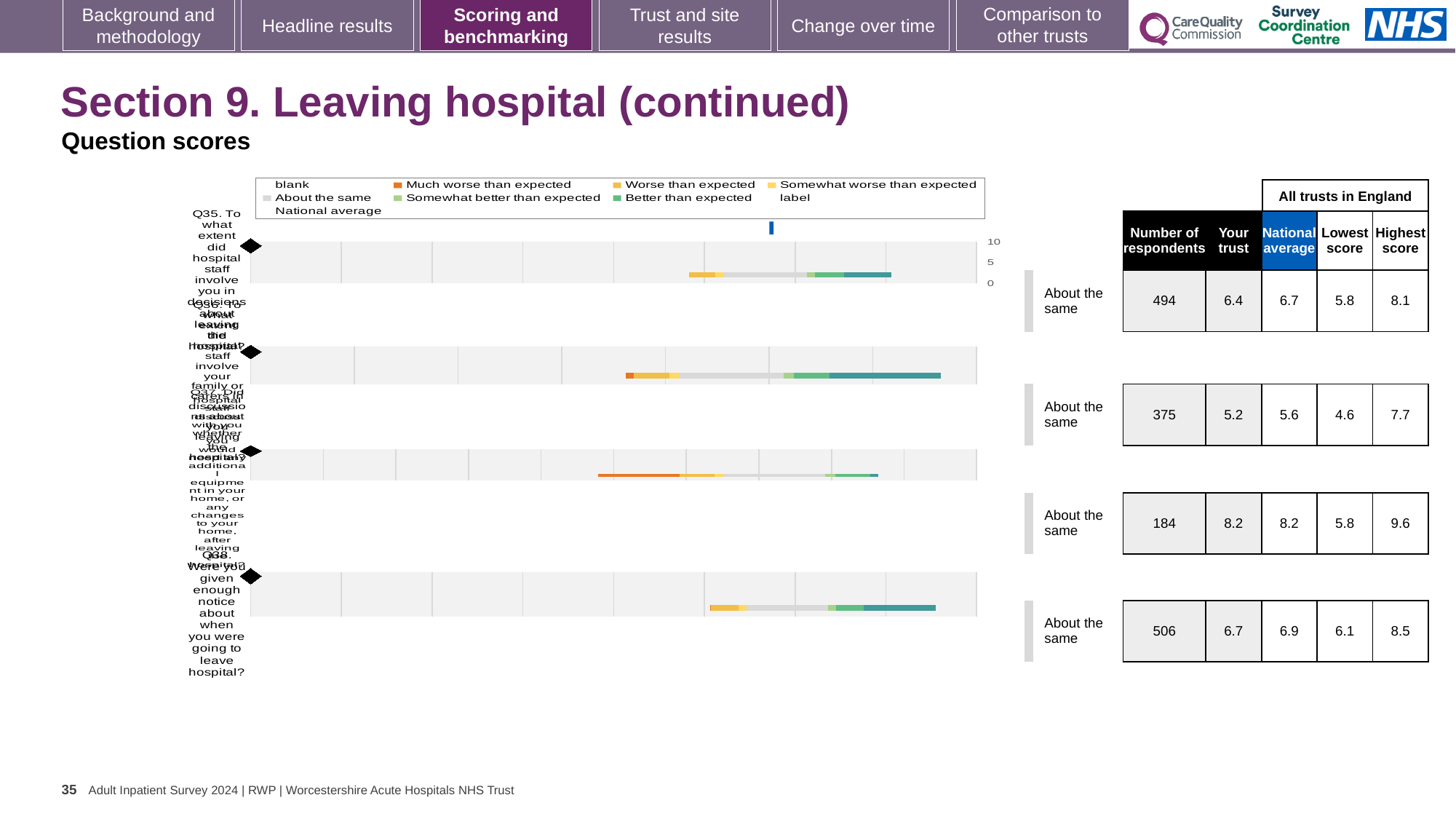
What kind of chart is used for each question on the slide? Bar chart Which question has the lowest 'Your trust' score? Q36 How many question charts are shown on the slide? 4 For Q37, what is the lowest score among all trusts in England? 5.8 For Q35 (the top chart), what is the 'Your trust' score shown in the table? 6.4 For Q38 (the bottom chart), how many respondents are there? 506 Which question has the highest 'Your trust' score? Q37 For Q36 (the second chart), what is the national average score? 5.6 For Q37 (the third chart), what is the highest score among all trusts in England? 9.6 For Q38, which is larger: the 'Your trust' score or the national average? National average For Q35, what is the difference between the national average and the 'Your trust' score? 0.3 What benchmark category is shown for Q36? About the same